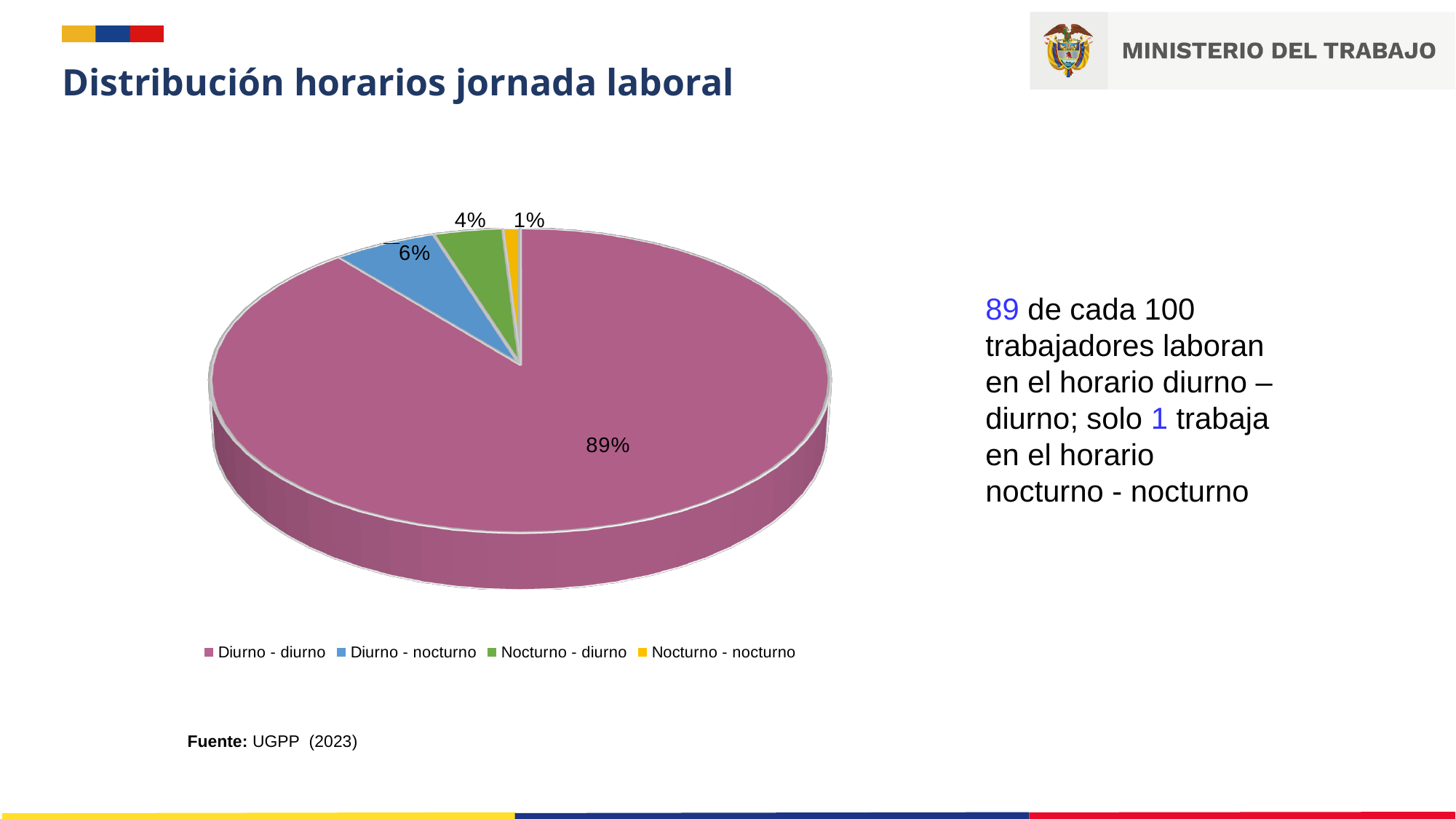
What colour is the Nocturno - nocturno slice in the legend? Yellow Which category has the largest slice of the pie? Diurno - diurno What is the value shown for Nocturno - diurno? 4% Which is larger, Diurno - nocturno or Nocturno - diurno? Diurno - nocturno What kind of chart is shown on the slide? Pie chart Which category has the smallest slice of the pie? Nocturno - nocturno How many categories are shown in the pie chart? 4 What share of the pie does the Diurno - diurno slice represent? 89% What is the difference in percentage points between Diurno - diurno and Diurno - nocturno? 83 What is the title of the chart on the slide? Distribución horarios jornada laboral What is the value shown for Nocturno - nocturno? 1% What is the value shown for Diurno - nocturno? 6%